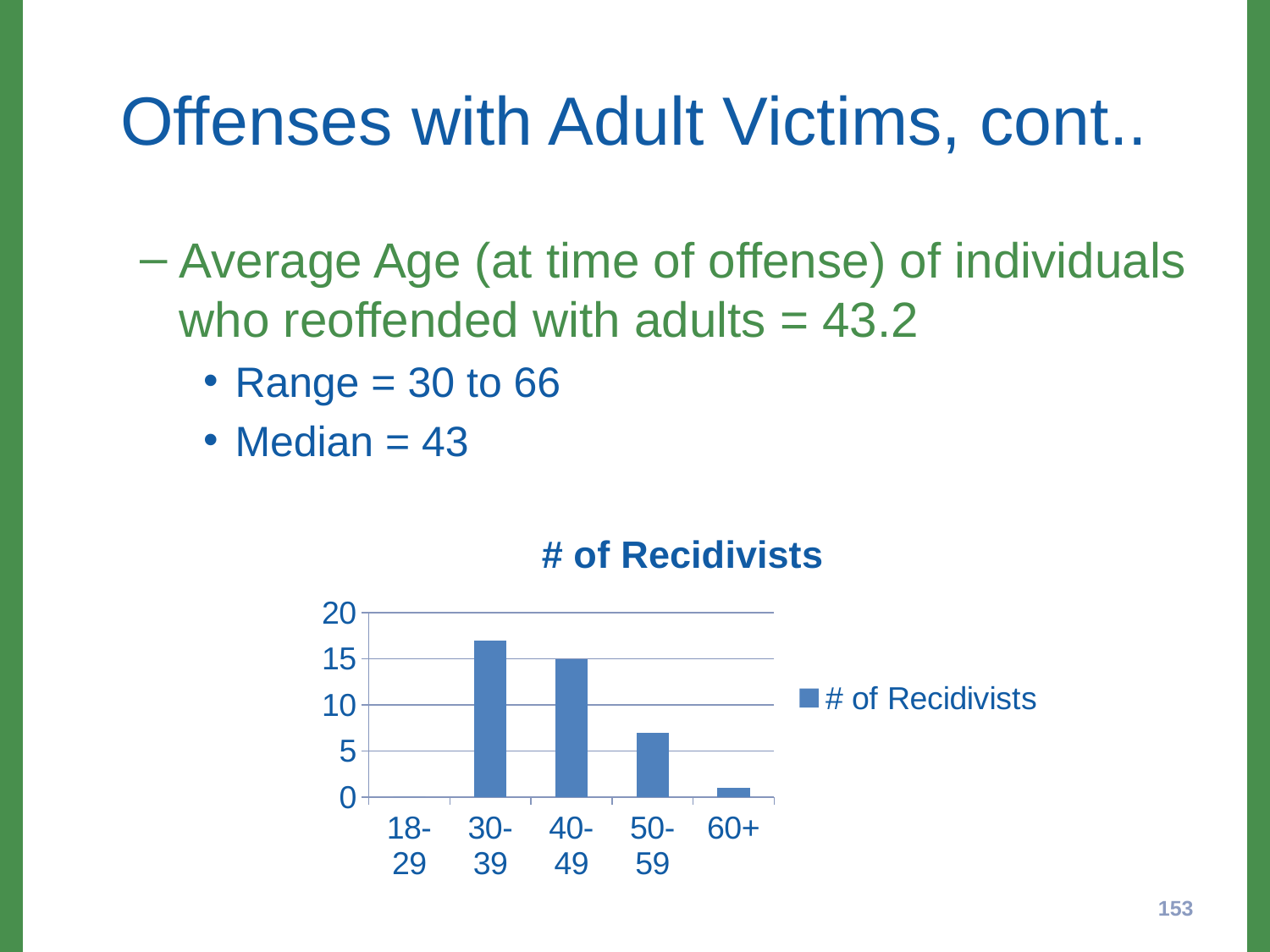
Which age category has the lowest number of recidivists? 18-29 What is the number of recidivists for the 40-49 age category? 15 Which age category has the highest number of recidivists? 30-39 Is the value for the 30-39 age category greater or less than 15? greater Is the value for the 60+ age category greater or less than 5? less What is the title of the chart? # of Recidivists From the 30-39 category to the 60+ category, do the values rise or fall? fall Which has more recidivists, the 40-49 category or the 50-59 category? 40-49 What kind of chart is shown on the slide? bar chart How many series does the chart legend list? 1 Is the value for the 50-59 age category greater or less than 10? less How many age categories are shown on the x axis of the chart? 5